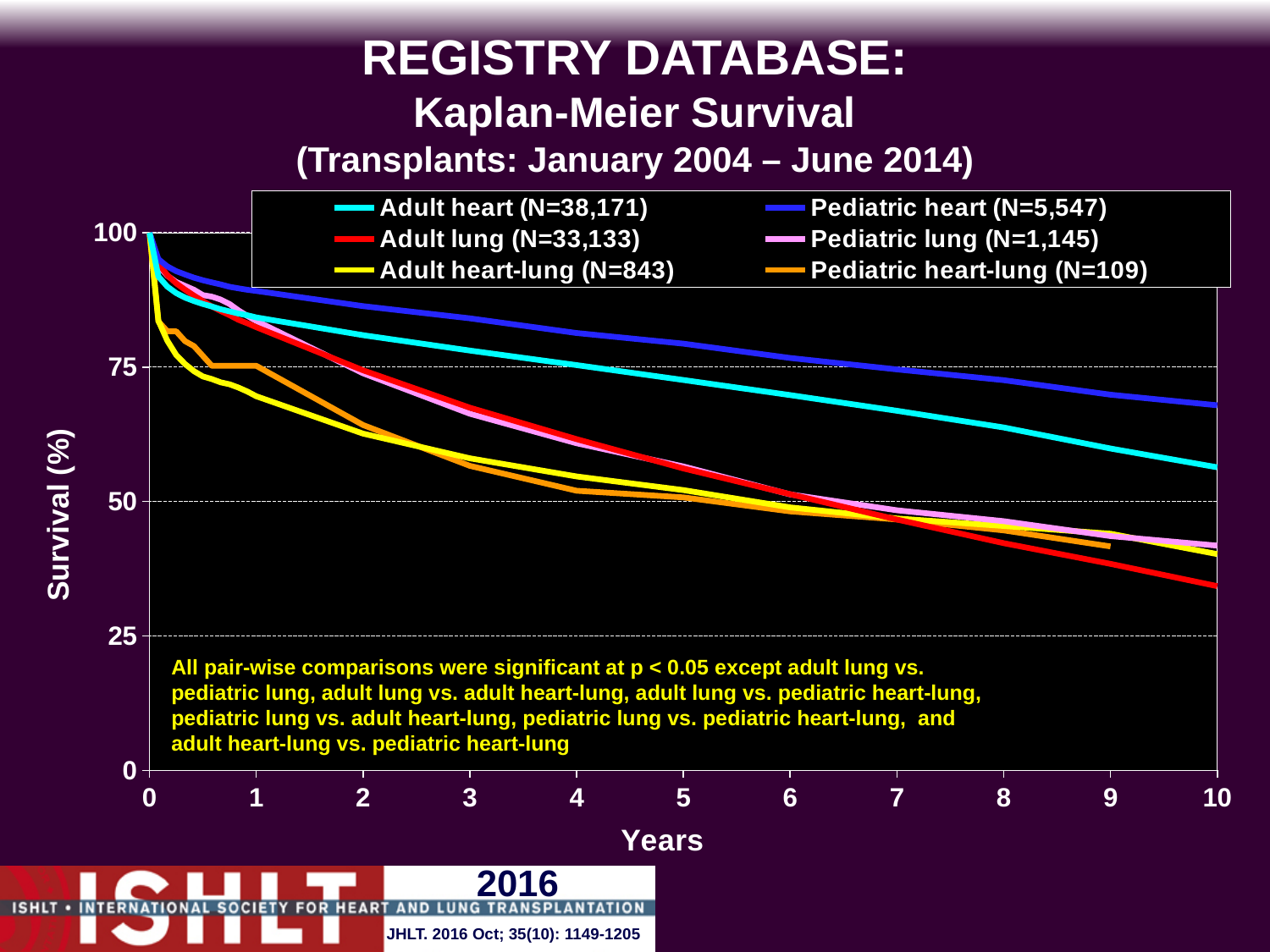
Is the survival for Adult heart-lung at 1 year greater or less than 75? less Is the survival for Adult lung at 10 years greater or less than 50? less At 10 years, which has higher survival: Adult heart or Pediatric heart? Pediatric heart What kind of chart is shown on the slide? Line chart How many series does the legend list? 6 Which series in the legend has the largest N? Adult heart (N=38,171) Which series has the lowest survival at 10 years? Adult lung Is the survival for Pediatric heart at 10 years greater or less than 50? greater Which series has the highest survival at 10 years? Pediatric heart What is the label of the y axis? Survival (%) Do the survival curves rise or fall as the years increase? Fall